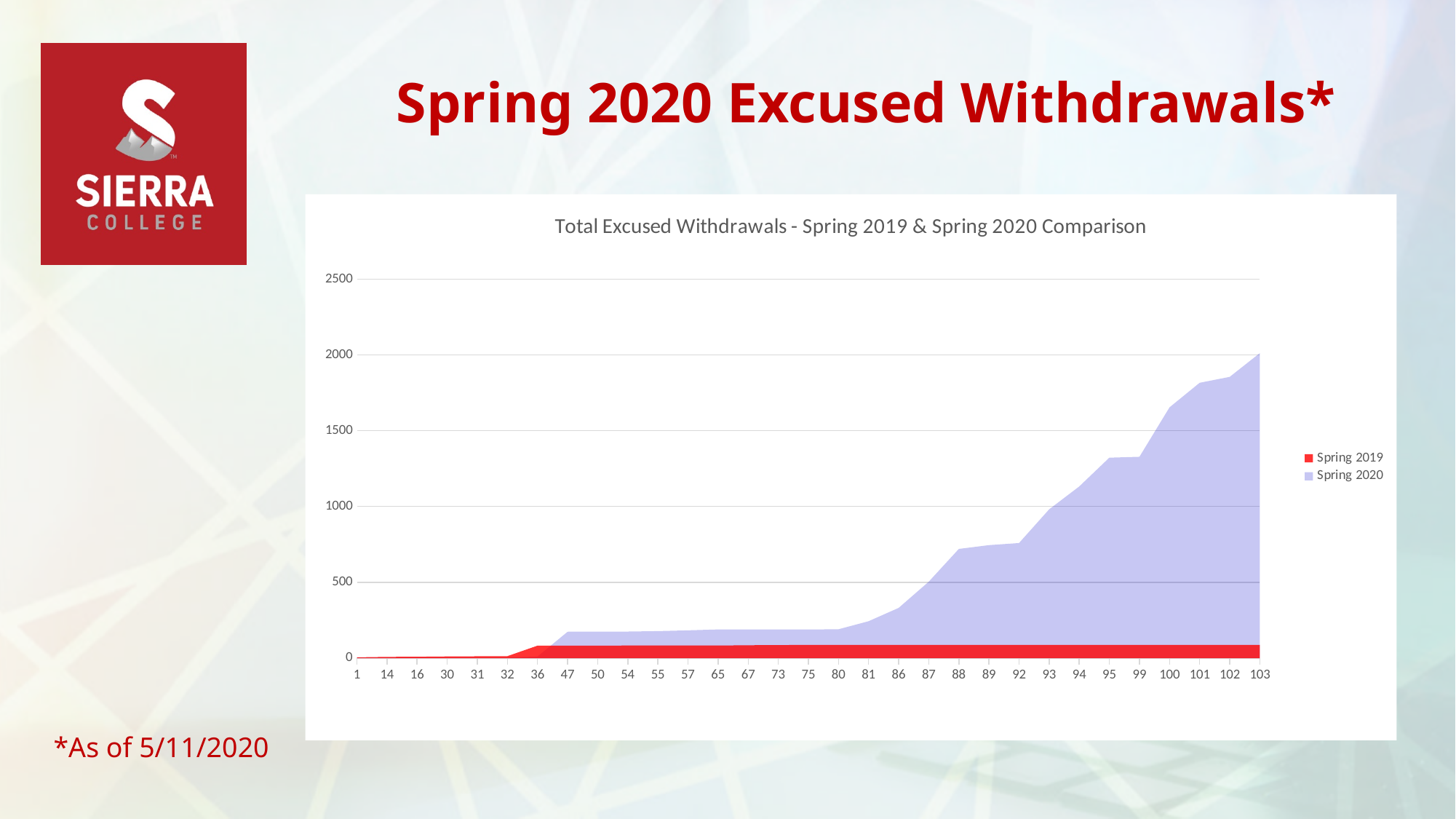
How many categories are shown along the x axis? 31 At which x-axis category does the Spring 2020 series reach its highest value? 103 What are the two series named in the legend? Spring 2019 and Spring 2020 What kind of chart is shown on the slide? Area chart Is the Spring 2019 value at category 103 greater or less than 500? less Do the Spring 2020 values generally rise or fall moving from left to right along the x axis? Rise What is the title of the chart? Total Excused Withdrawals - Spring 2019 & Spring 2020 Comparison How many series does the legend list? 2 At category 103, which series has the larger value, Spring 2019 or Spring 2020? Spring 2020 Is the Spring 2020 value at category 88 greater or less than 500? greater Is the Spring 2020 value at category 103 greater or less than 1500? greater